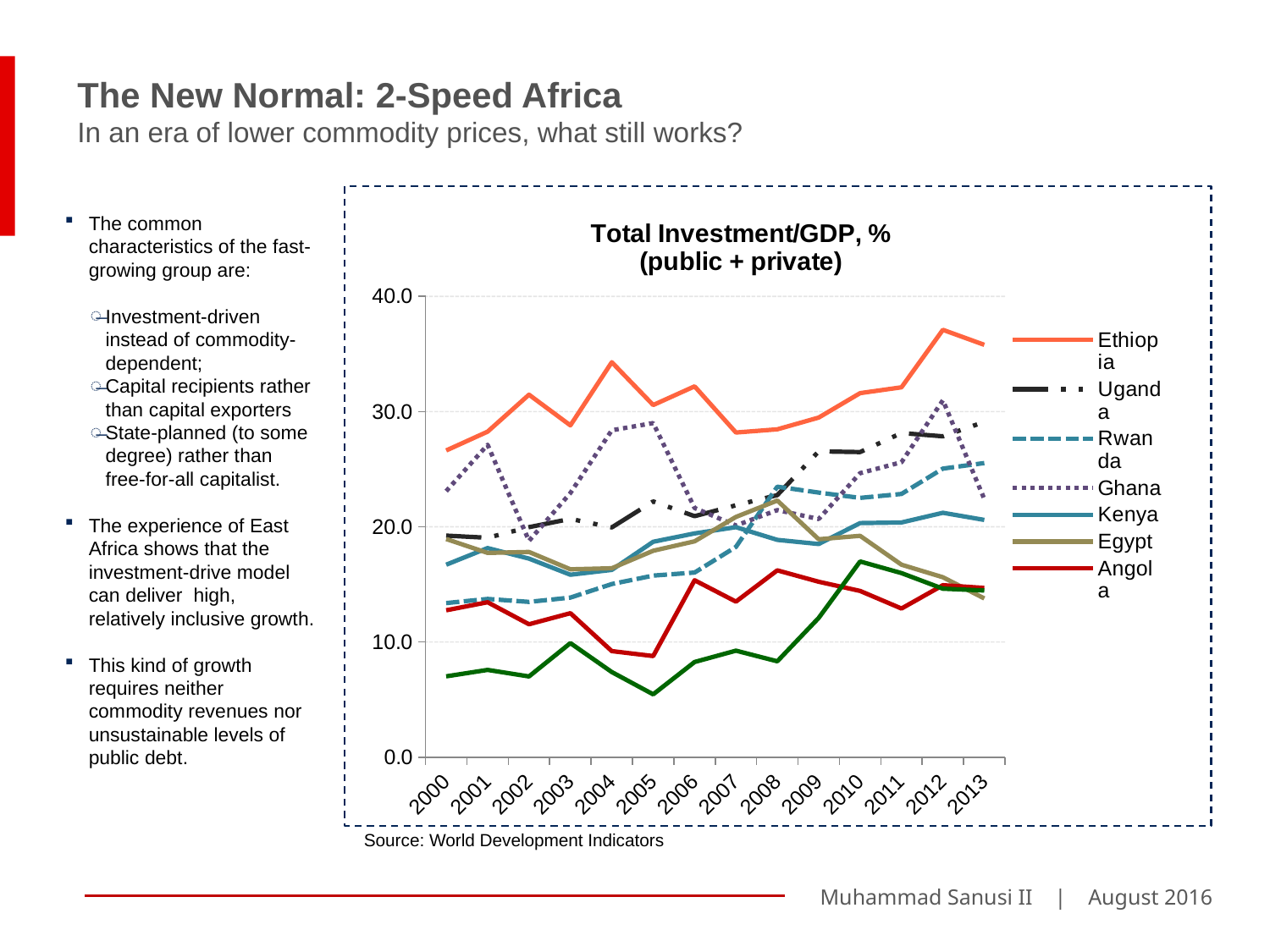
Is the value for Rwanda in 2013 greater or less than 20.0? greater Which series has the highest value in 2013? Ethiopia Does the Ethiopia line generally rise or fall from 2000 to 2013? rise Is the value for Kenya in 2000 greater or less than 20.0? less Is the value for Ethiopia in 2012 greater or less than 30.0? greater How many series does the chart's legend list? 7 What kind of chart is shown on the slide? line chart How many years are shown along the x axis of the chart? 14 In 2008, which is larger: the value for Ethiopia or the value for Angola? Ethiopia What is the title of the chart? Total Investment/GDP, % (public + private)